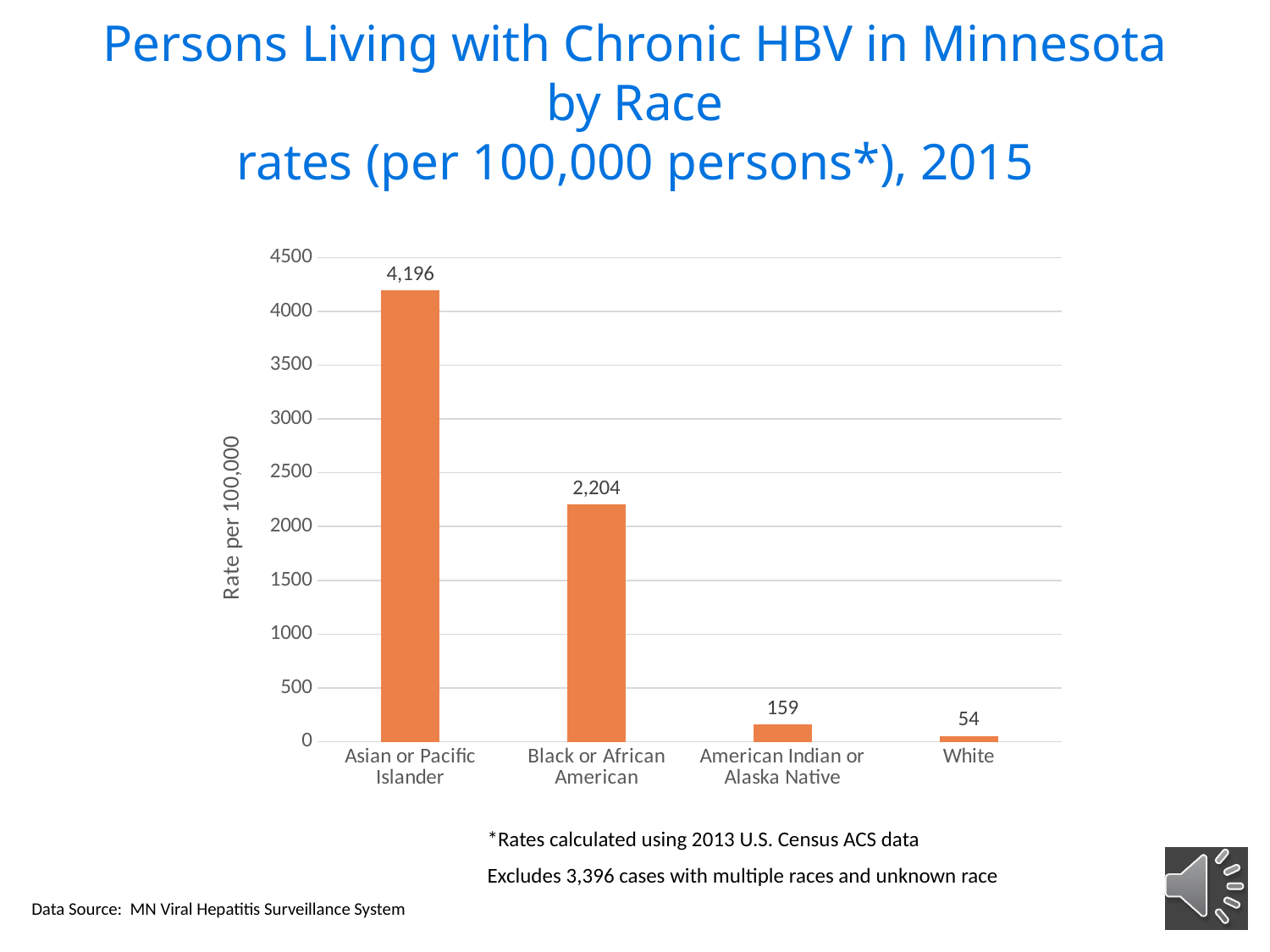
How many race categories are shown in the chart? 4 Which race category has the lowest rate? White What is the rate per 100,000 for American Indian or Alaska Native? 159 What is the rate per 100,000 for White? 54 What kind of chart is shown on the slide? Bar chart What is the difference between the rates for American Indian or Alaska Native and White? 105 What is the rate per 100,000 for Black or African American? 2,204 Is the value for Black or African American greater or less than 2000? greater What is the rate per 100,000 for Asian or Pacific Islander? 4,196 What is the difference between the rates for Asian or Pacific Islander and Black or African American? 1,992 Which race category has the highest rate? Asian or Pacific Islander Which has a higher rate, Black or African American or American Indian or Alaska Native? Black or African American